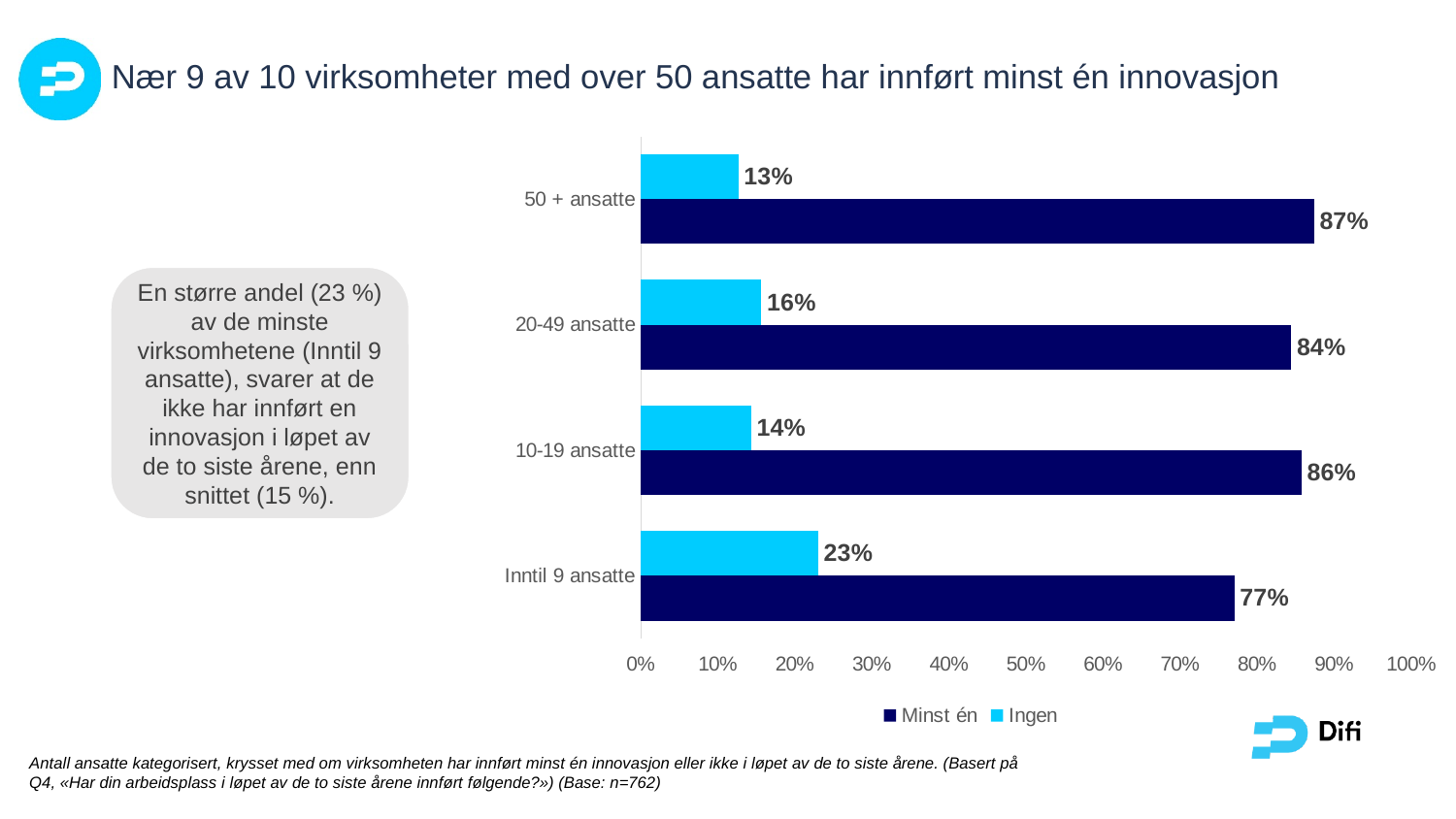
What is the value of "Ingen" for "Inntil 9 ansatte"? 23% Which category has the lowest "Ingen" value? 50 + ansatte What is the value of "Minst én" for "50 + ansatte"? 87% How many employee-size categories are shown in the chart? 4 What kind of chart is shown on the slide? Bar chart What is the value of "Ingen" for "20-49 ansatte"? 16% Which category has the highest "Minst én" value? 50 + ansatte Which colour represents the "Ingen" series in the chart? Light blue What is the difference between the "Minst én" values for "50 + ansatte" and "Inntil 9 ansatte"? 10% How many series does the legend list? 2 Which is larger: the "Ingen" value for "10-19 ansatte" or for "20-49 ansatte"? 20-49 ansatte What is the value of "Minst én" for "10-19 ansatte"? 86%